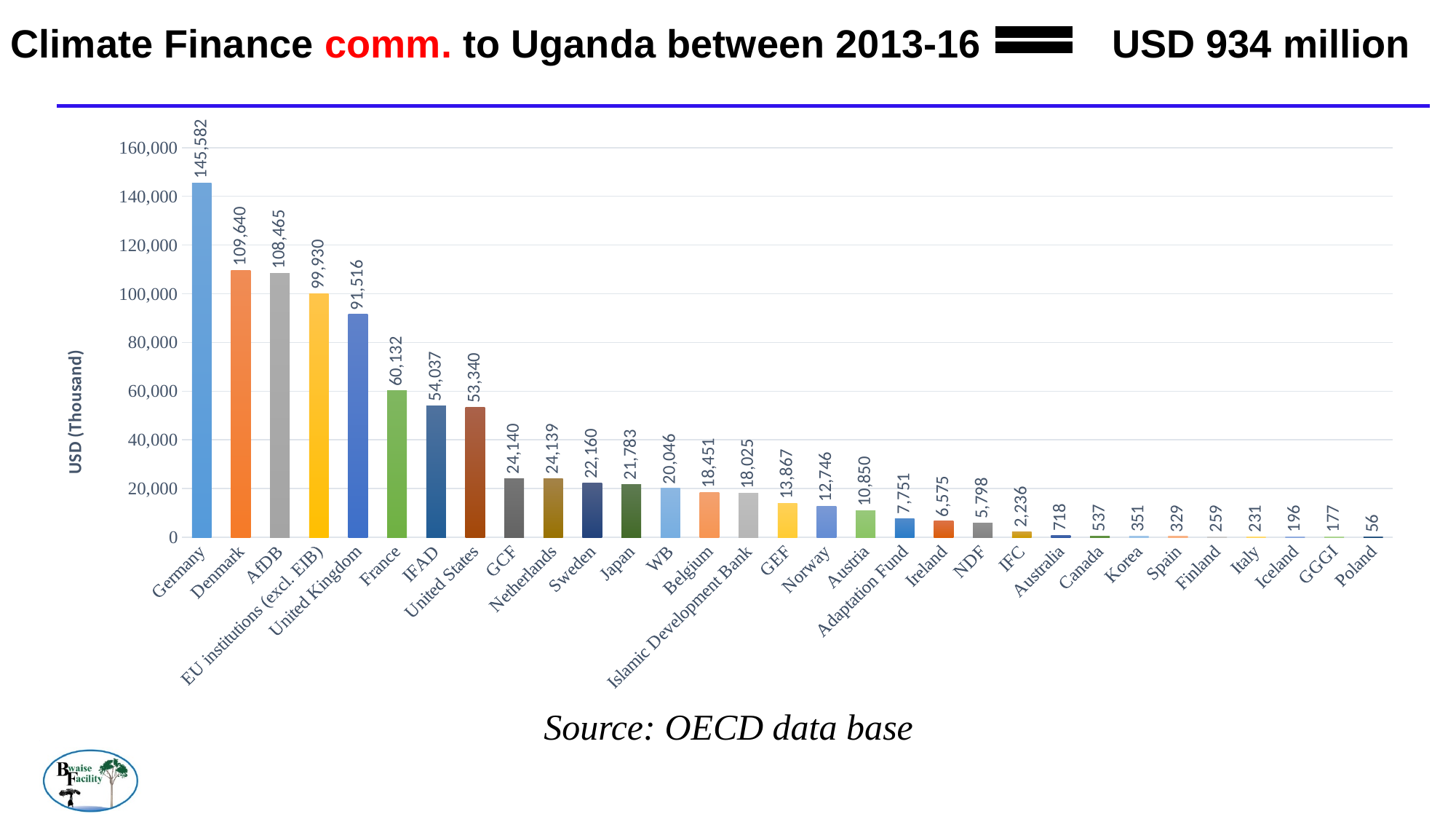
What kind of chart is shown on the slide? Bar chart Which category has the highest value? Germany Which is larger, the value for Japan or the value for WB? Japan What is the value for Germany? 145,582 What is the value for the United Kingdom? 91,516 What is the difference between the values for France and IFAD? 6,095 What is the difference between the values for Germany and Denmark? 35,942 How many categories are shown on the chart? 31 What is the value for Poland? 56 Which category has the lowest value? Poland What is the label of the vertical axis? USD (Thousand) What is the value for the Adaptation Fund? 7,751